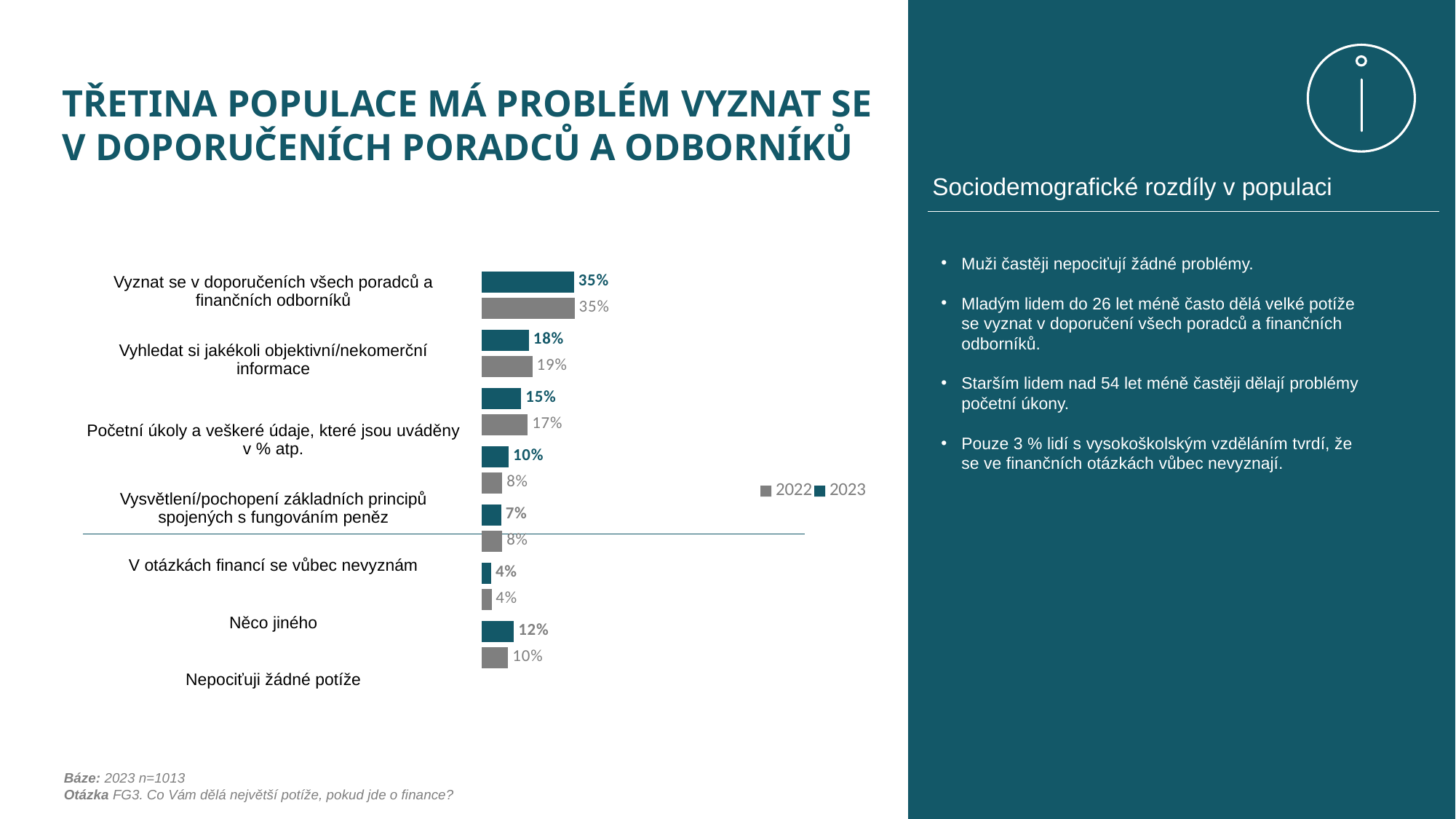
Which category has the lowest 2022 value? V otázkách financí se vůbec nevyznám What is the 2023 value for 'Početní úkoly a veškeré údaje, které jsou uváděny v % atp.'? 15% How many series does the legend list? 2 What is the 2022 value for 'Vyhledat si jakékoli objektivní/nekomerční informace'? 19% What is the 2023 value for 'Vyznat se v doporučeních všech poradců a finančních odborníků'? 35% What is the 2023 value for 'Nepociťuji žádné potíže'? 12% What kind of chart is shown on the slide? bar chart Which colour represents the 2022 series in the chart? grey Which category has the highest 2023 value? Vyznat se v doporučeních všech poradců a finančních odborníků What is the difference between the 2022 and 2023 values for 'Početní úkoly a veškeré údaje, které jsou uváděny v % atp.'? 2% How many categories are shown in the chart? 7 For 'Vysvětlení/pochopení základních principů spojených s fungováním peněz', which year has the larger value, 2022 or 2023? 2022